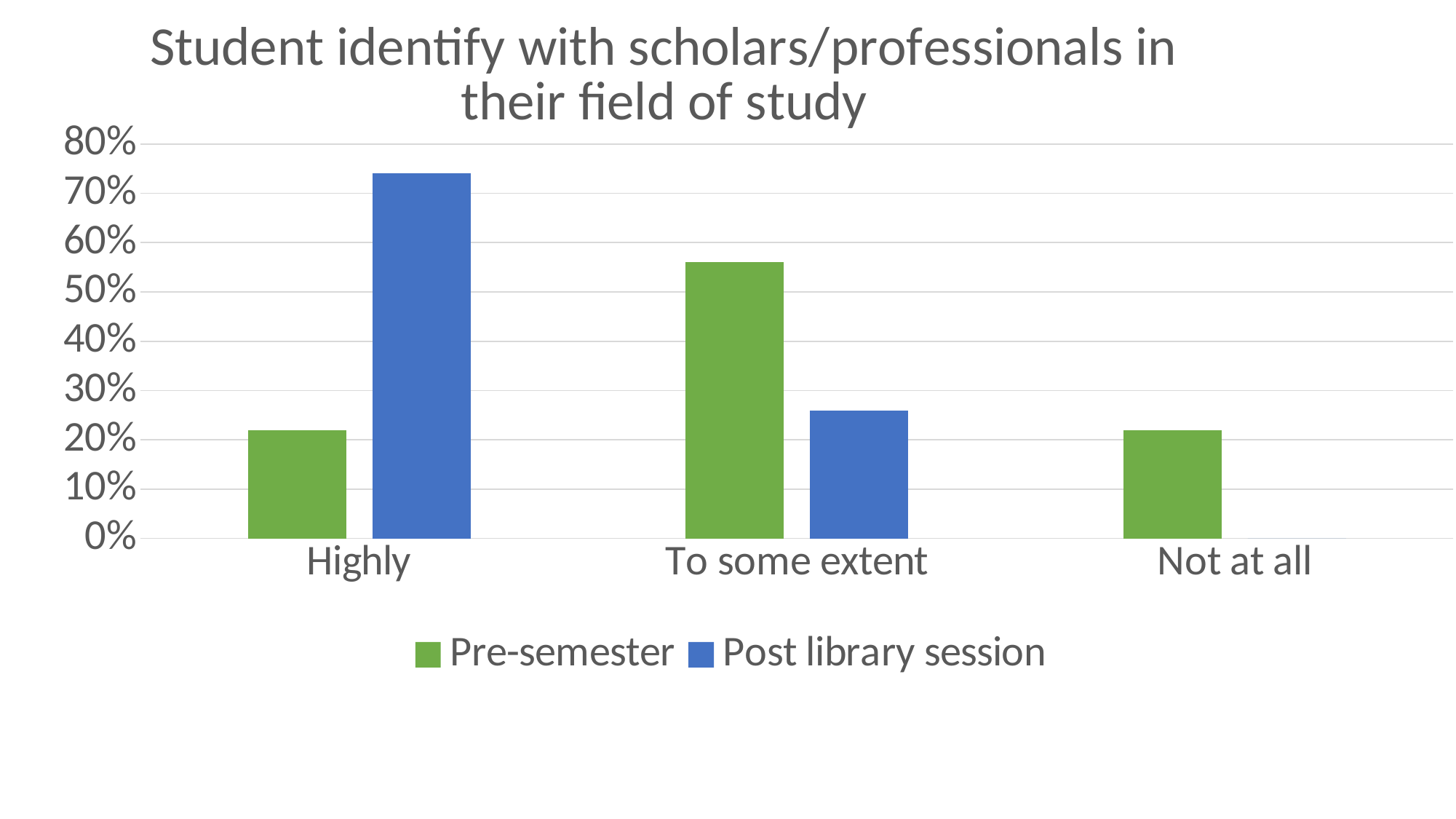
Is the Post library session value for To some extent greater or less than 30%? less Which category has the highest Post library session value? Highly Which category has the highest Pre-semester value? To some extent For the Highly category, which series has the larger value, Pre-semester or Post library session? Post library session How many series does the legend list? 2 What type of chart is shown on the slide? bar chart Is the Pre-semester value for To some extent greater or less than 50%? greater Is the Post library session value for Highly greater or less than 70%? greater What colour represents the Post library session series? blue How many categories are shown on the x axis? 3 For the To some extent category, which series has the larger value, Pre-semester or Post library session? Pre-semester